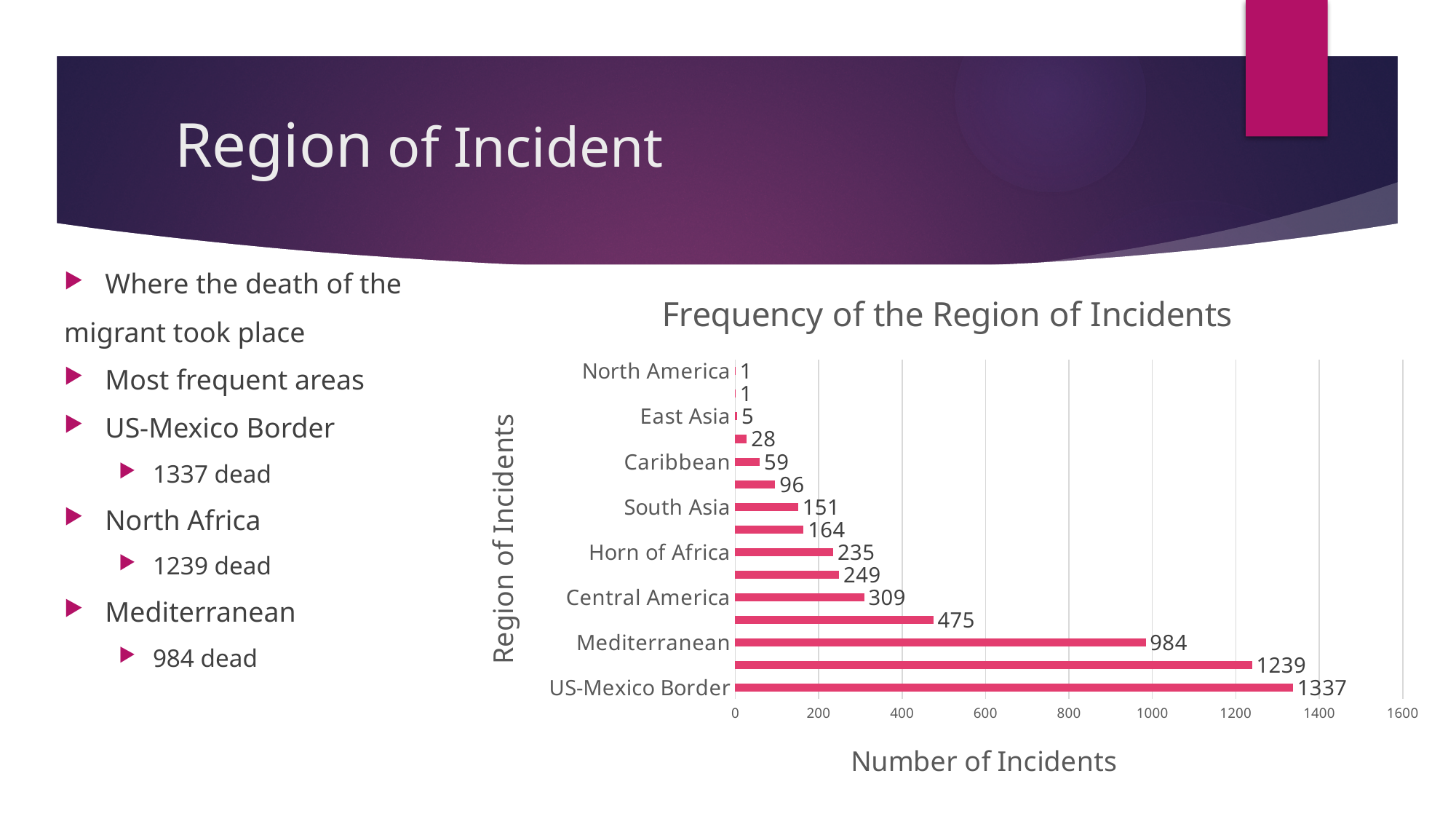
What is the number of incidents for the Mediterranean? 984 How many bars are plotted in the chart? 15 What is the difference in the number of incidents between the US-Mexico Border and the Mediterranean? 353 What is the label of the horizontal axis of the chart? Number of Incidents Which has more incidents, the Caribbean or South Asia? South Asia What is the number of incidents for East Asia? 5 What type of chart is shown on the slide? Bar chart What is the number of incidents for the Horn of Africa? 235 What is the number of incidents for Central America? 309 Which region has the highest number of incidents? US-Mexico Border What is the number of incidents for the US-Mexico Border? 1337 What is the title of the chart? Frequency of the Region of Incidents